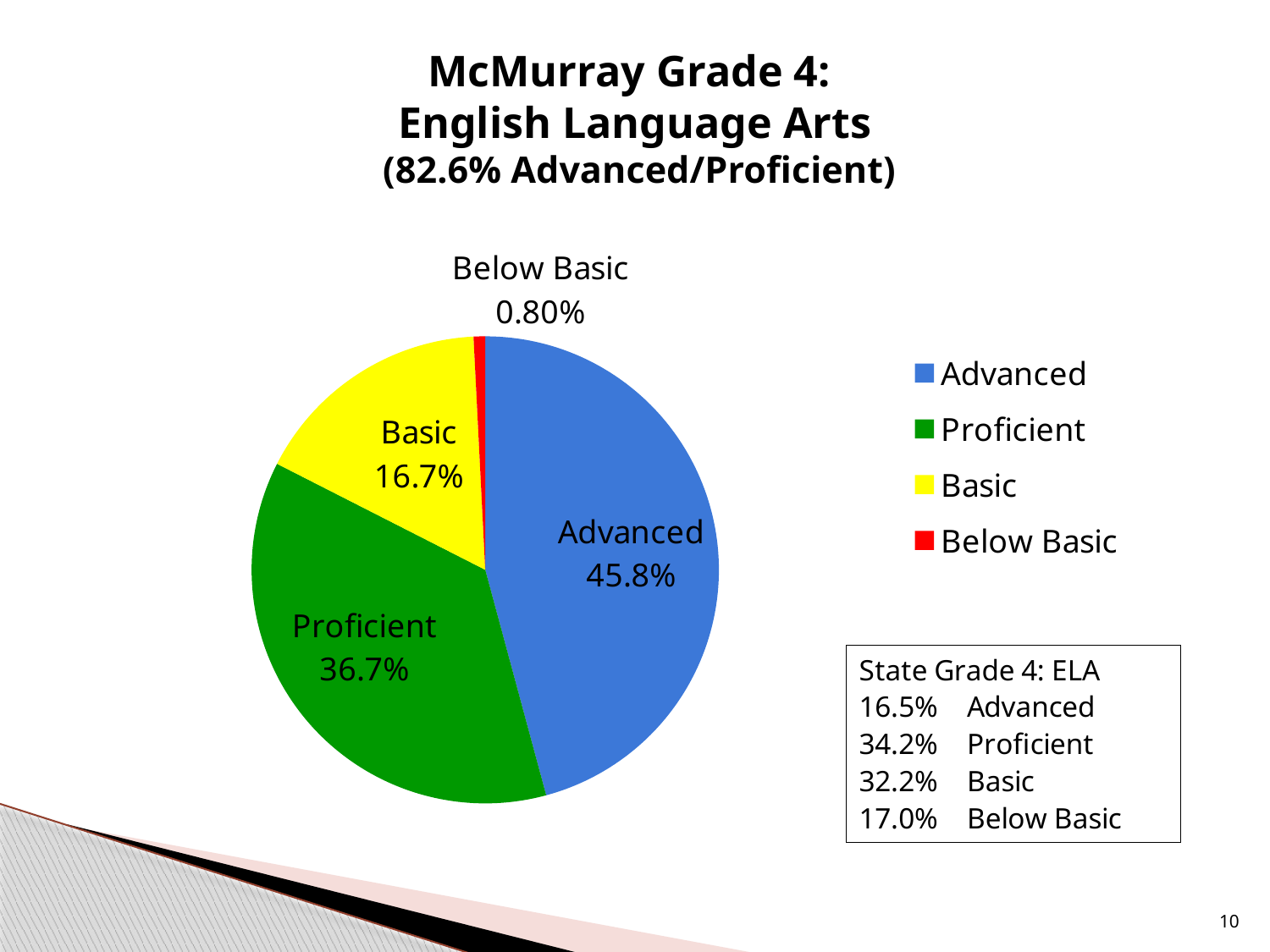
Which slice is larger, Basic or Proficient? Proficient What is the title of the chart on the slide? McMurray Grade 4: English Language Arts (82.6% Advanced/Proficient) Which category has the largest share of the pie? Advanced What percentage of students are in the Proficient category? 36.7% What colour represents the Basic category in the pie chart? Yellow Which category has the smallest share of the pie? Below Basic How many categories are shown in the pie chart? 4 What percentage of McMurray Grade 4 students scored Advanced in English Language Arts? 45.8% What percentage of students are in the Basic category? 16.7% What type of chart is shown on the slide? Pie chart What percentage of students are in the Below Basic category? 0.80% What is the difference in percentage points between the Advanced and Proficient slices? 9.1